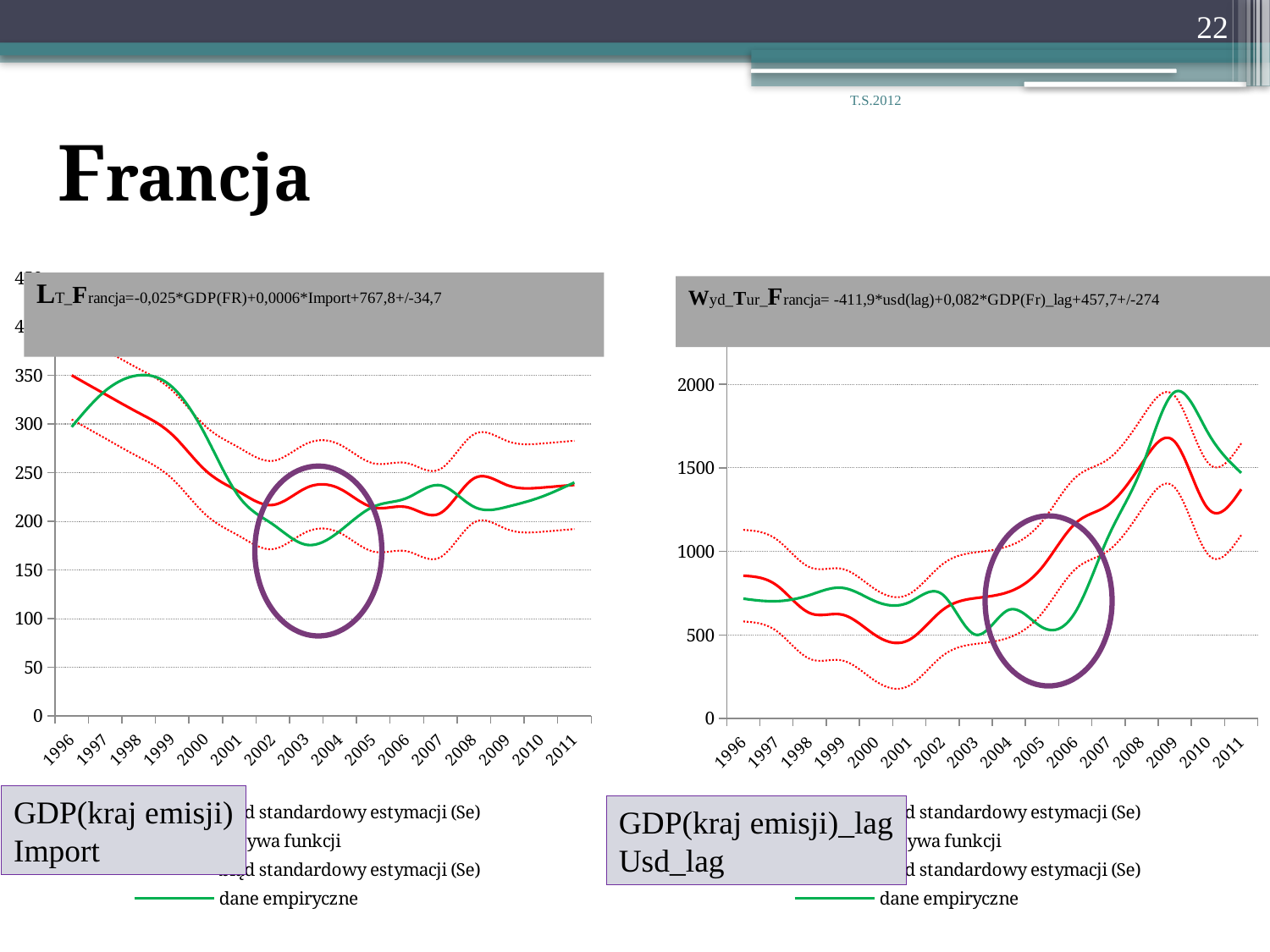
In the left chart, is the value of the red 'krzywa funkcji' line in 2003 greater or less than 200? greater In the right chart, is the value of the green 'dane empiryczne' line in 2009 greater or less than 1500? greater In the right chart, is the value of the green 'dane empiryczne' line in 2005 greater or less than 1000? less In the right chart, does the green 'dane empiryczne' line rise or fall between 2005 and 2009? rise In the right chart, in which year does the green 'dane empiryczne' line reach its highest value? 2009 How many entries does the legend of the left chart list? 4 How many years are shown on the x axis of the right chart? 16 In the left chart, does the green 'dane empiryczne' line rise or fall between 1998 and 2003? fall What type of chart is the left chart on the slide? line chart